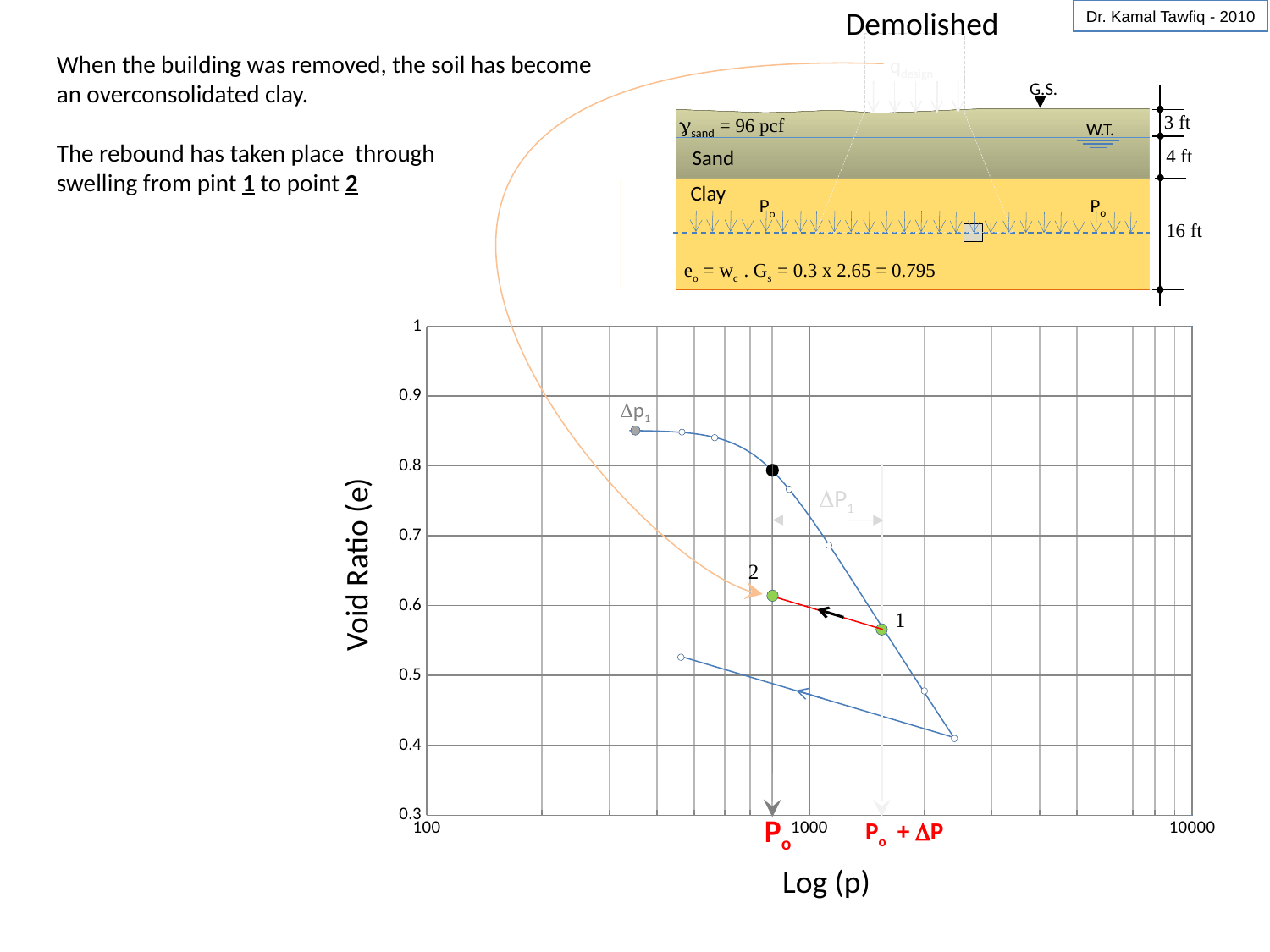
What is the title of the vertical axis of the chart? Void Ratio (e) Along the main loading curve, does the void ratio rise or fall as the pressure p increases? fall Which has the higher void ratio, point 1 or point 2? point 2 Is the void ratio at point 1 greater or less than 0.5? greater Is the void ratio at point 2 greater or less than 0.6? greater Is the void ratio at the lowest point of the curve greater or less than 0.5? less What is the title of the horizontal axis of the chart? Log (p) What kind of chart is shown on the slide? line chart What is the highest value shown on the vertical axis of the chart? 1